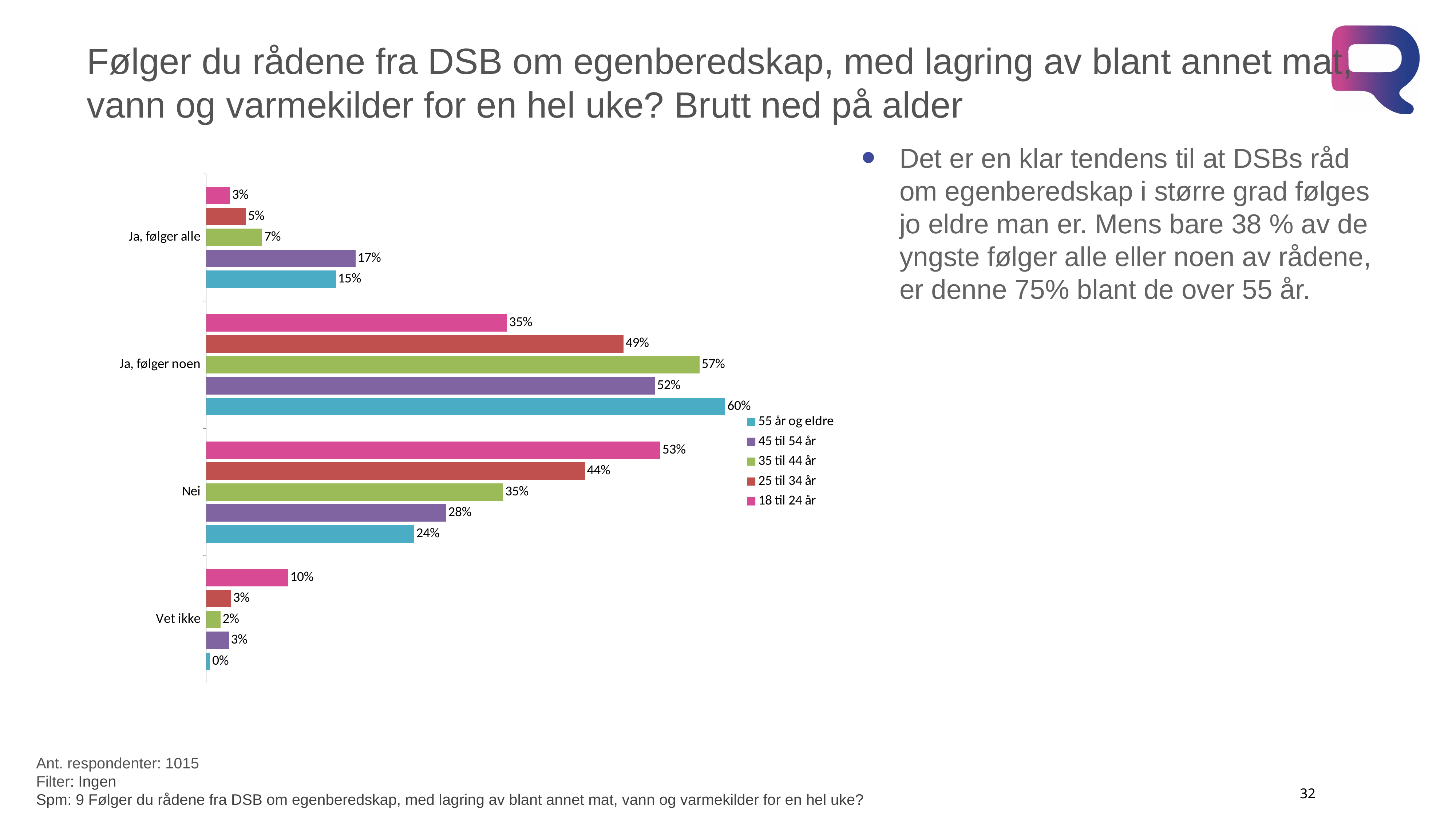
What is the value for '45 til 54 år' in the 'Ja, følger alle' category? 17% How many series does the legend list? 5 What is the difference between the '55 år og eldre' and '18 til 24 år' values in the 'Ja, følger noen' category? 25% Which legend entry is shown in pink? 18 til 24 år What is the value for '55 år og eldre' in the 'Ja, følger noen' category? 60% Which age group has the lowest value in the 'Ja, følger alle' category? 18 til 24 år How many response categories are shown on the chart? 4 In the 'Nei' category, which is larger: the value for '25 til 34 år' or the value for '35 til 44 år'? 25 til 34 år What is the value for '35 til 44 år' in the 'Vet ikke' category? 2% Which age group has the highest value in the 'Nei' category? 18 til 24 år What kind of chart is shown on the slide? bar chart What is the value for '18 til 24 år' in the 'Nei' category? 53%